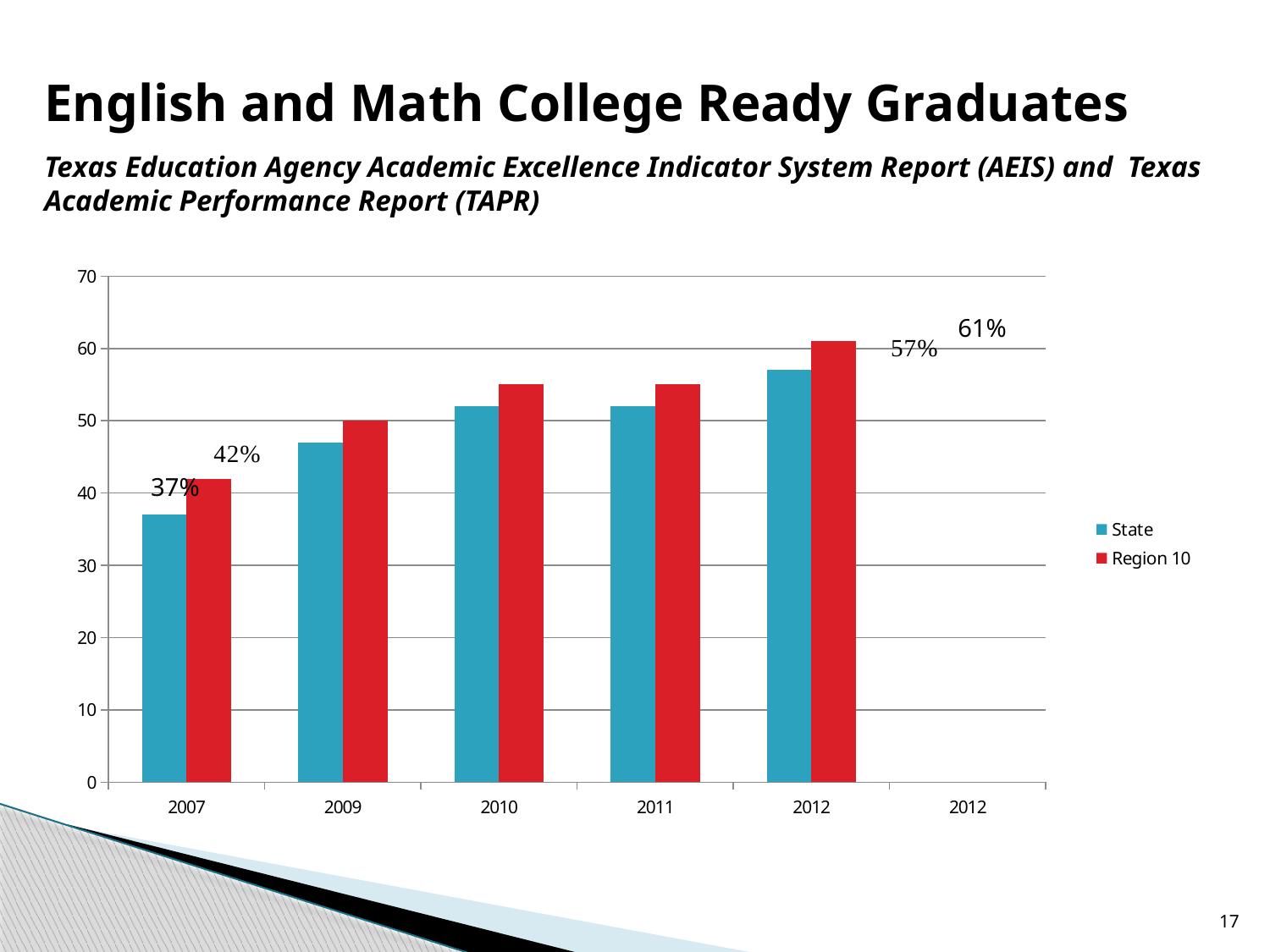
In 2007, which is larger, State or Region 10? Region 10 What is the Region 10 value for 2007? 42% What kind of chart is shown on the slide? bar chart By how many percentage points does Region 10 exceed State in 2007? 5 How many series does the legend list? 2 Which year has the highest Region 10 value? 2012 By how many percentage points does Region 10 exceed State in 2012? 4 Is the Region 10 value for 2010 greater or less than 50? greater What is the State value for 2007? 37% What is the Region 10 value for 2012? 61% Is the State value for 2009 greater or less than 50? less What is the State value for 2012? 57%